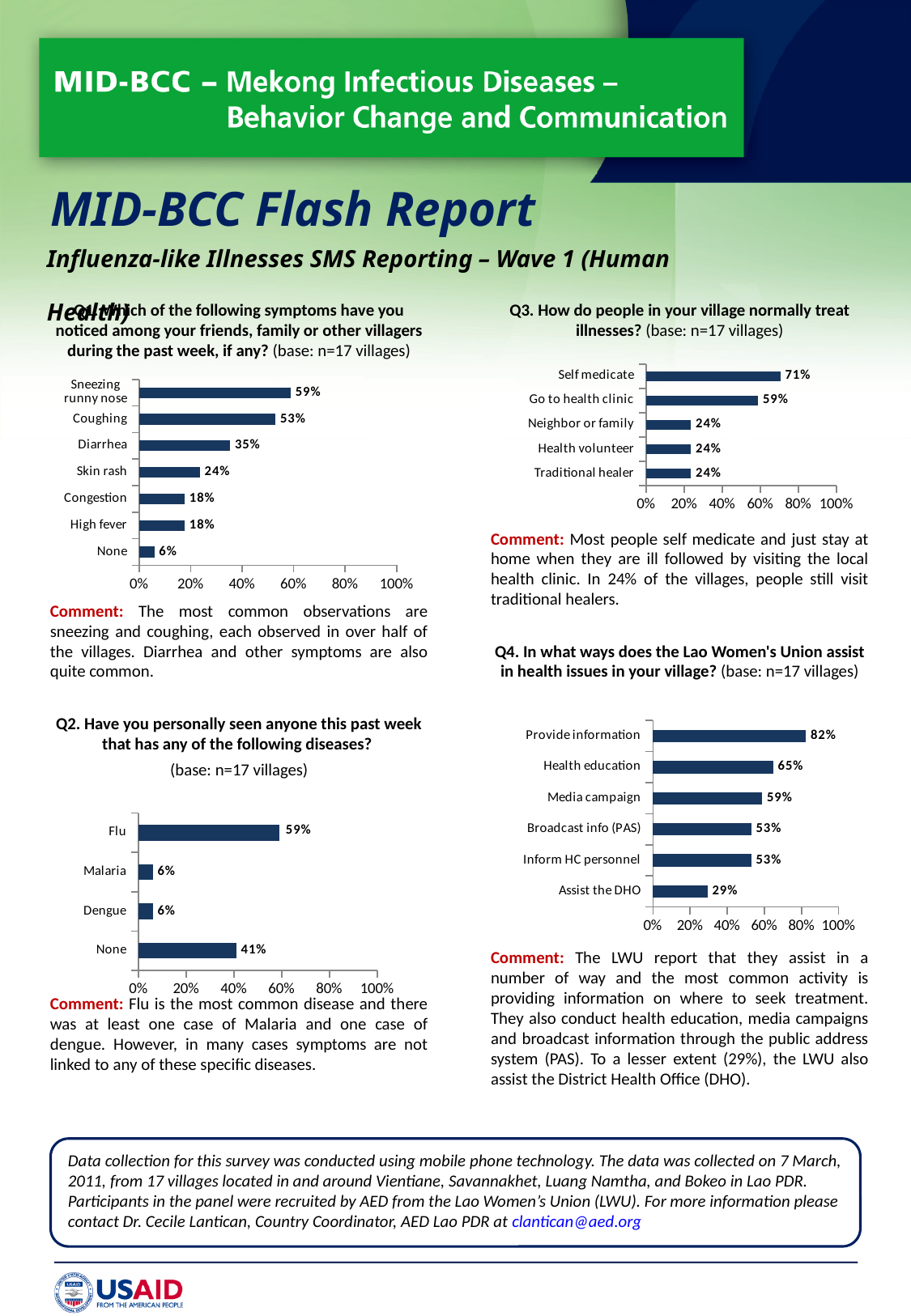
What type of chart is used for Q4 on the slide? Bar chart In the Q4 Lao Women's Union chart, which category has the lowest value? Assist the DHO In the Q1 symptoms chart, what percentage of villages reported coughing? 53% In the Q2 diseases chart, what is the value for Flu? 59% In the Q1 symptoms chart, which symptom has the lowest value? None In the Q2 diseases chart, which is larger, the value for None or the value for Malaria? None In the Q4 Lao Women's Union chart, what is the value for Provide information? 82% In the Q3 treatment chart, what is the value for Traditional healer? 24% In the Q1 symptoms chart, how many symptom categories are plotted? 7 In the Q1 symptoms chart, what is the difference between the values for Diarrhea and Skin rash? 11% In the Q3 treatment chart, which category has the highest value? Self medicate In the Q3 treatment chart, what is the difference between Self medicate and Go to health clinic? 12%